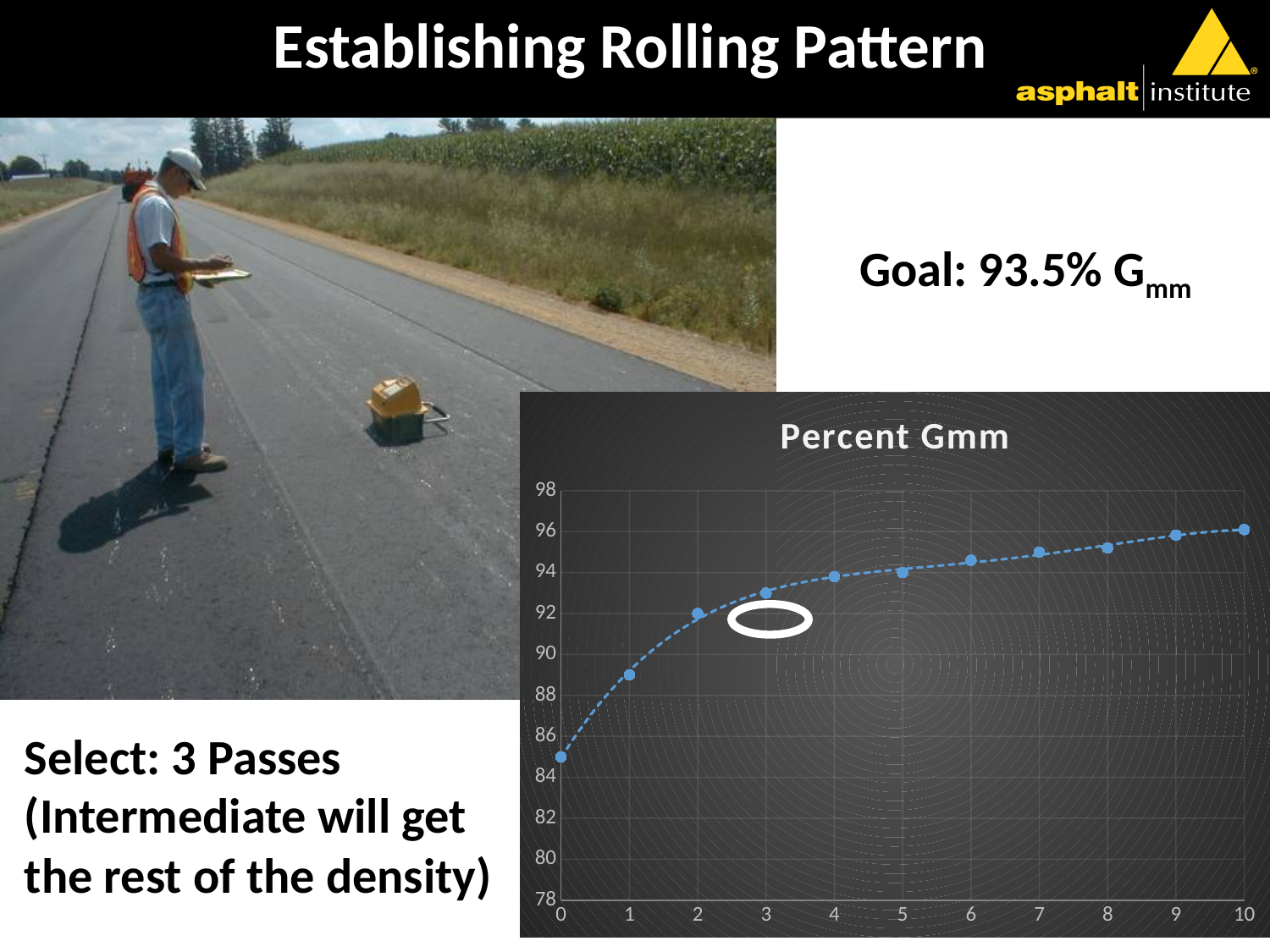
What is the title of the chart? Percent Gmm At which x-axis value is the plotted value lowest? 0 Is the value at x = 7 greater or less than 96? less How many data points are plotted on the chart? 11 Do the plotted values rise or fall as the x-axis value increases from 0 to 10? rise Is the value at x = 0 greater or less than 86? less What is the highest value shown on the y-axis? 98 Which has the larger plotted value, x = 1 or x = 5? x = 5 Is the value at x = 1 greater or less than 88? greater What kind of chart is shown on the slide? line chart At which x-axis value is the plotted value highest? 10